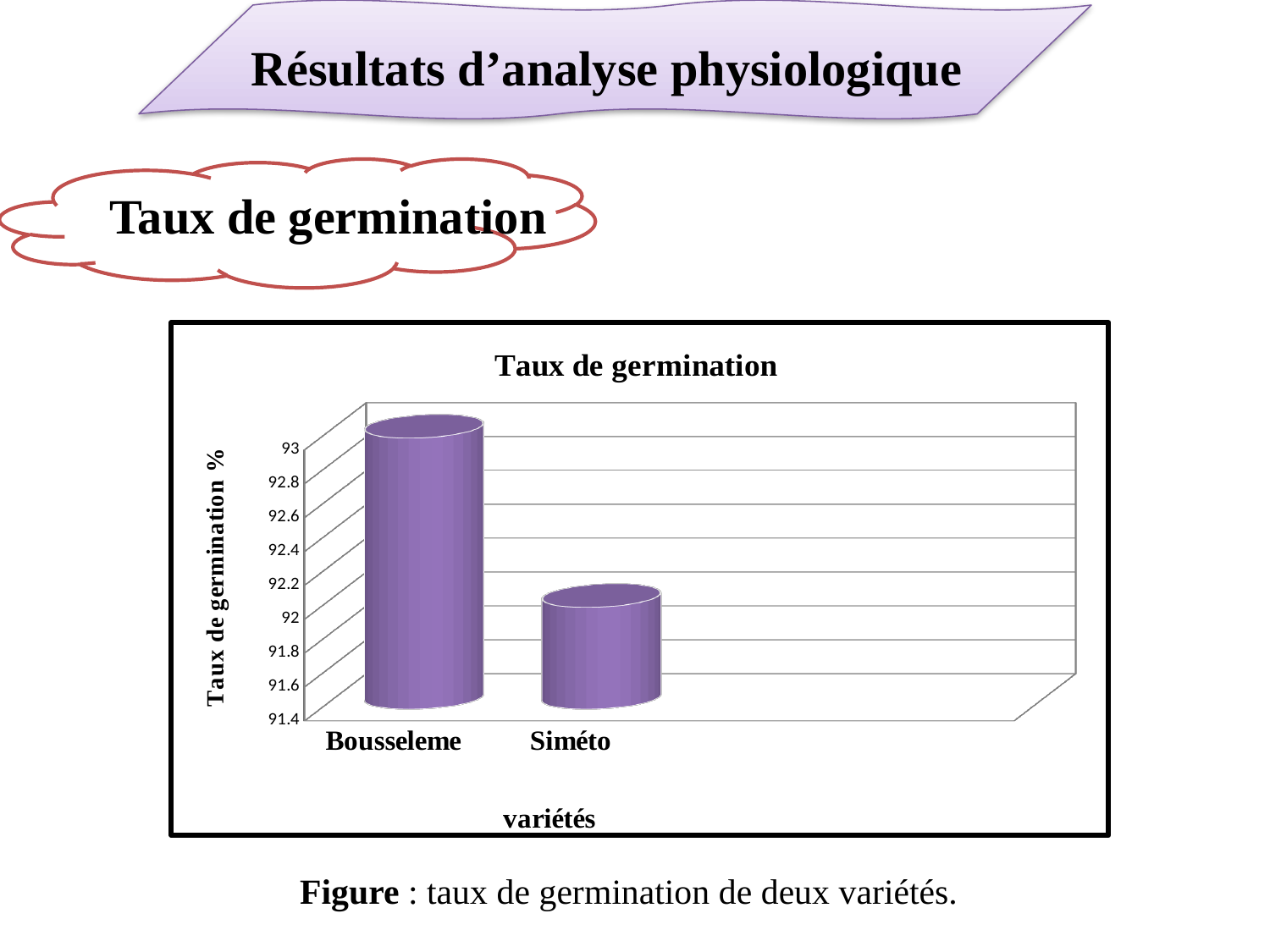
Is the germination rate for Siméto greater or less than 92.4? less Is the germination rate for Bousseleme greater or less than 92.6? greater Is the germination rate for Siméto greater or less than 91.8? greater Which variety has the highest germination rate? Bousseleme What is the label of the vertical axis of the chart? Taux de germination % Which variety has the lowest germination rate? Siméto How many varieties (categories) are plotted in the chart? 2 Which has the larger germination rate, Bousseleme or Siméto? Bousseleme What is the title of the chart? Taux de germination What kind of chart is shown on the slide? bar chart Do the values rise or fall from Bousseleme to Siméto along the x axis? fall